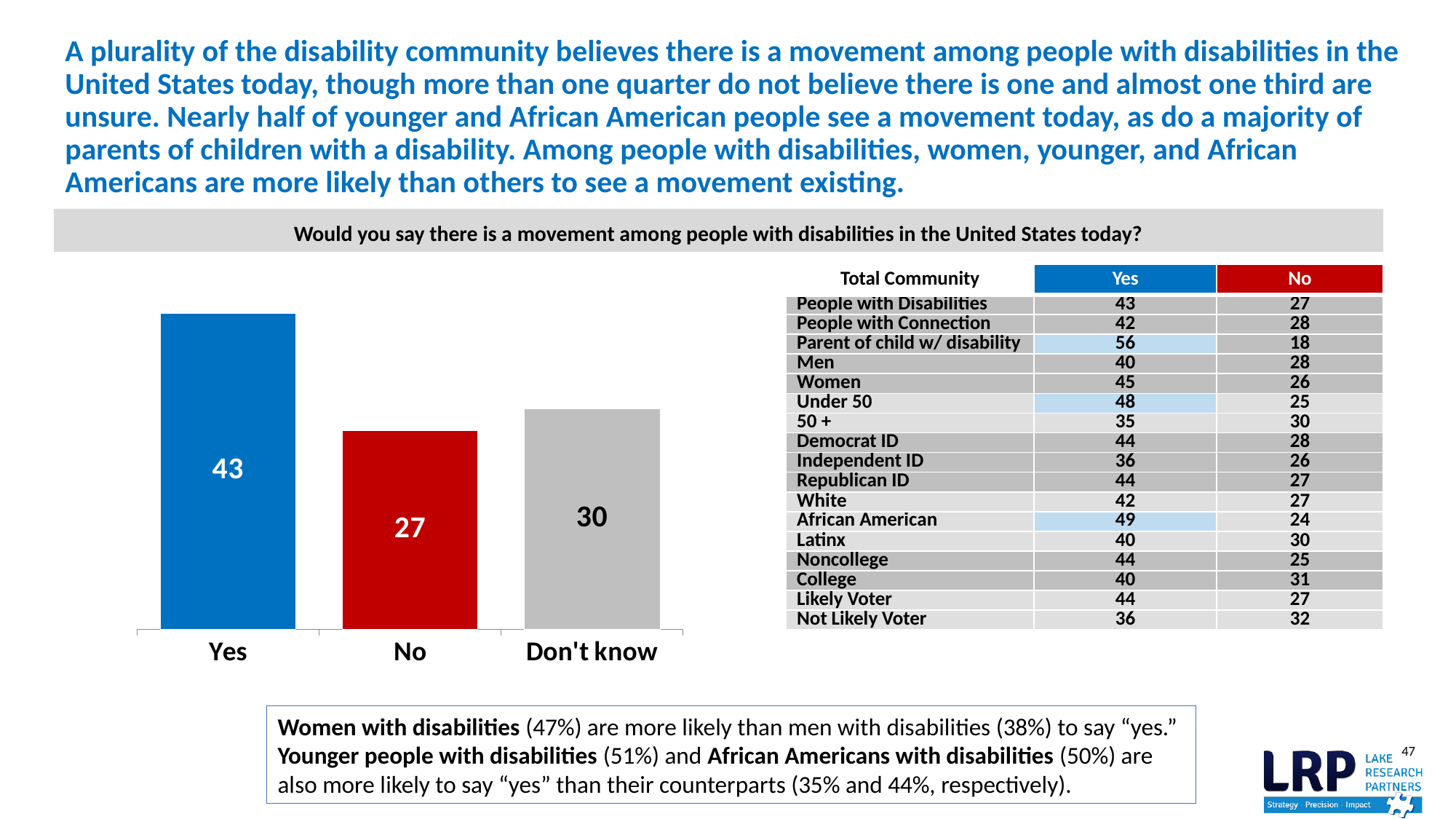
What is the value of the Yes bar in the chart? 43 Which category has the lowest value in the chart? No What colour is the No bar in the chart? Red Which category has the highest value in the chart? Yes What colour is the Yes bar in the chart? Blue What is the value of the No bar in the chart? 27 What kind of chart is shown on the slide? Bar chart How many categories are shown in the bar chart? 3 Which is larger in the chart, Yes or Don't know? Yes What is the difference between the Yes and No values in the chart? 16 What is the difference between the Don't know and No values in the chart? 3 What is the value of the Don't know bar in the chart? 30